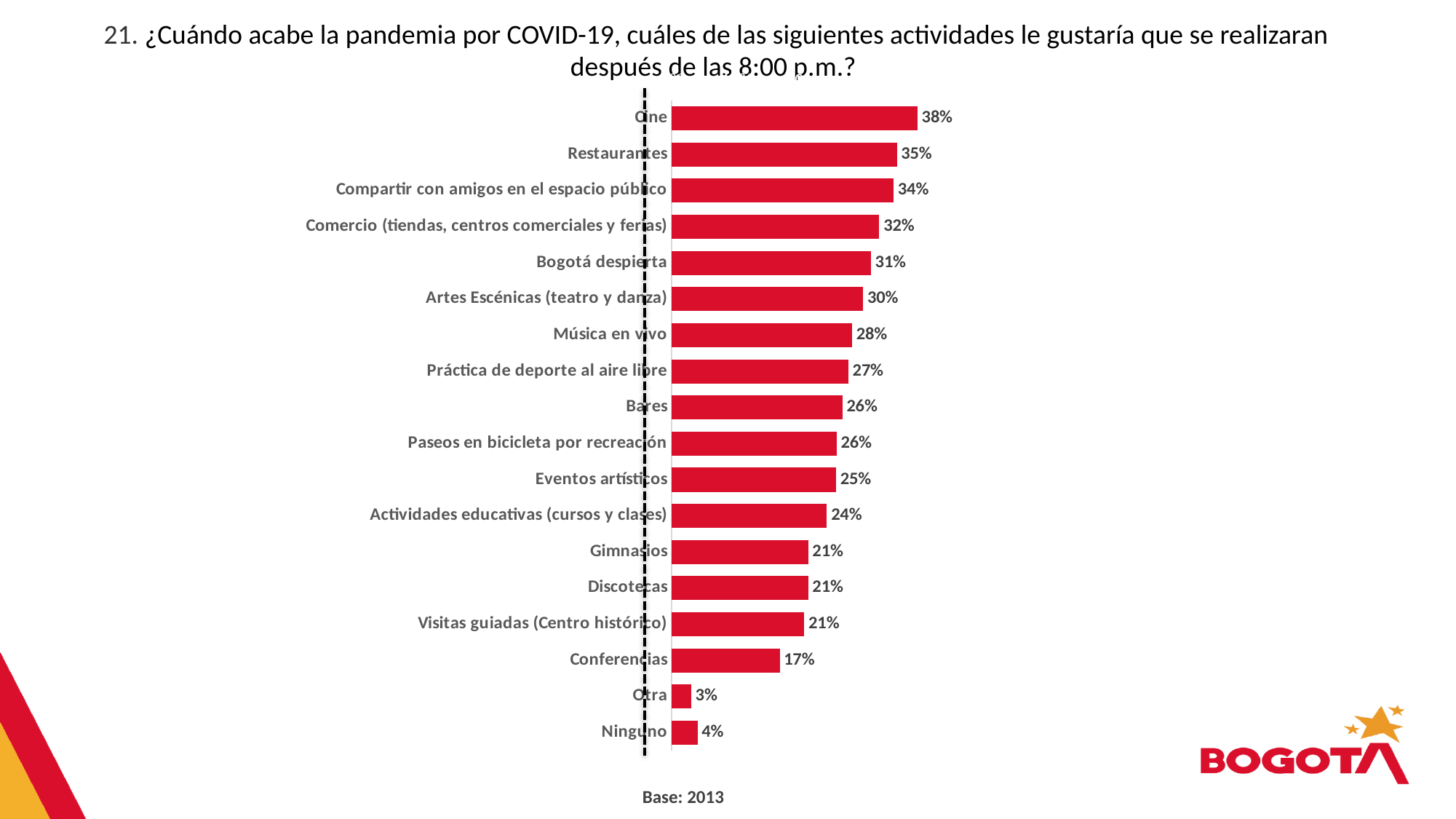
What is the difference between the values for Gimnasios and Conferencias? 4% Which category has the lowest value? Otra What is the difference between the values for Cine and Restaurantes? 3% What is the value for Bogotá despierta? 31% What is the value for Conferencias? 17% Which category has the highest value? Cine What kind of chart is shown on the slide? bar chart How many categories are shown in the chart? 18 What is the value for Música en vivo? 28% What is the value for Cine? 38% Which is larger, the value for Bares or the value for Discotecas? Bares What base (sample size) is stated below the chart? 2013